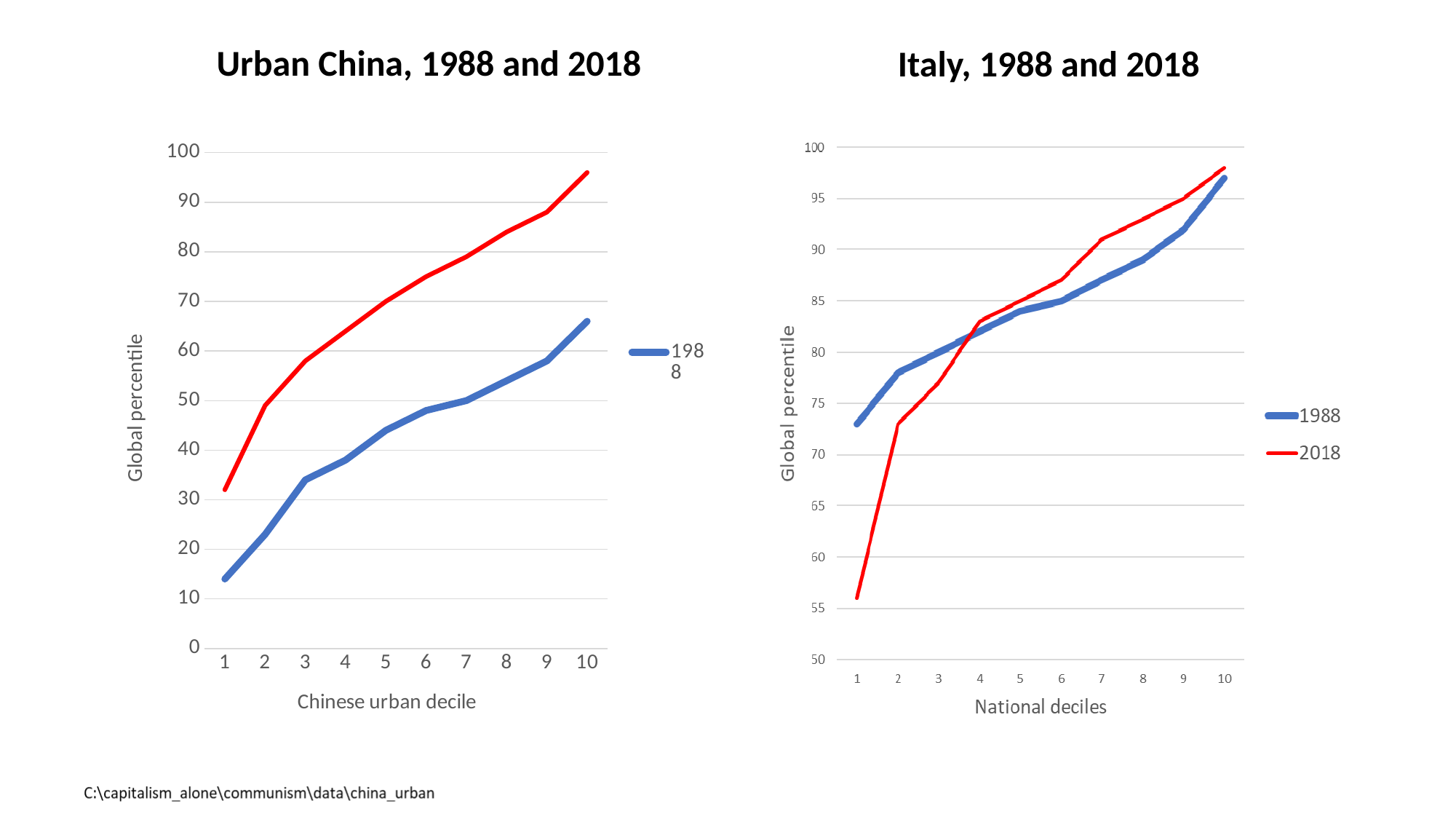
In the 'Urban China, 1988 and 2018' chart, at decile 5, which line is higher, 1988 or 2018? 2018 In the 'Urban China, 1988 and 2018' chart, is the 1988 value for decile 10 greater or less than 60? greater In the 'Italy, 1988 and 2018' chart, how many series does the legend list? 2 What is the x-axis title of the 'Italy, 1988 and 2018' chart? National deciles In the 'Urban China, 1988 and 2018' chart, how many deciles are shown on the x axis? 10 In the 'Italy, 1988 and 2018' chart, at decile 2, which line is higher, 1988 or 2018? 1988 In the 'Urban China, 1988 and 2018' chart, is the 1988 value for decile 1 greater or less than 20? less In the 'Italy, 1988 and 2018' chart, is the 1988 value for decile 1 greater or less than 70? greater What kind of chart is the 'Urban China, 1988 and 2018' chart? line chart In the 'Urban China, 1988 and 2018' chart, do the values rise or fall as the decile increases? rise